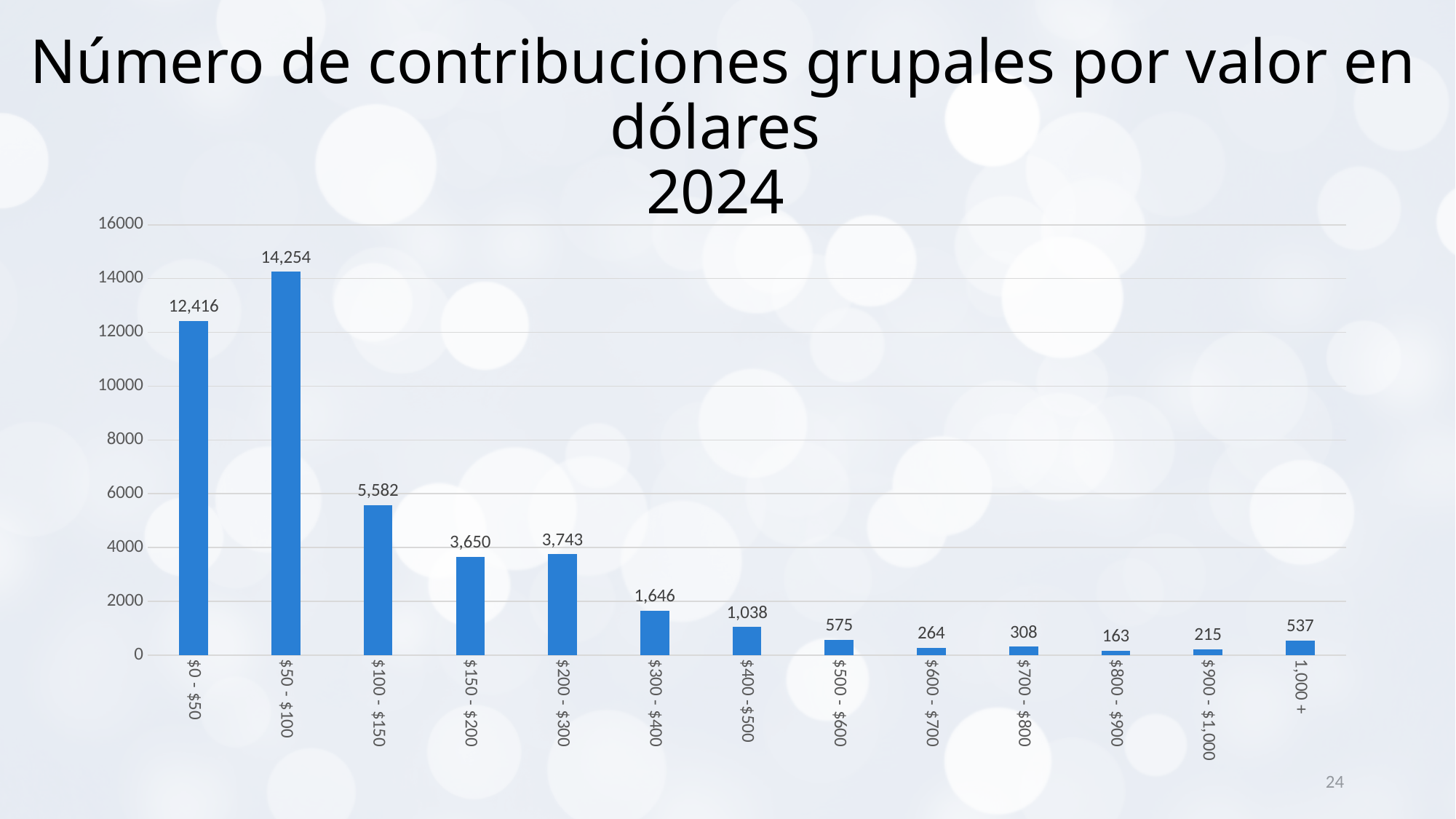
What is the difference between the contributions in the $700 - $800 range and the $600 - $700 range? 44 What is the difference between the contributions in the $50 - $100 range and the $0 - $50 range? 1,838 What is the number of contributions for the $300 - $400 range? 1,646 What is the number of contributions for the $1,000 + range? 537 What year does the chart title refer to? 2024 How many dollar ranges are shown on the x axis? 13 Which dollar range has the lowest number of contributions? $800 - $900 What kind of chart is shown on the slide? Bar chart Which dollar range has the highest number of contributions? $50 - $100 Which has more contributions, the $150 - $200 range or the $200 - $300 range? $200 - $300 What is the number of contributions for the $50 - $100 range? 14,254 Is the value for the $100 - $150 range greater or less than 4000? greater